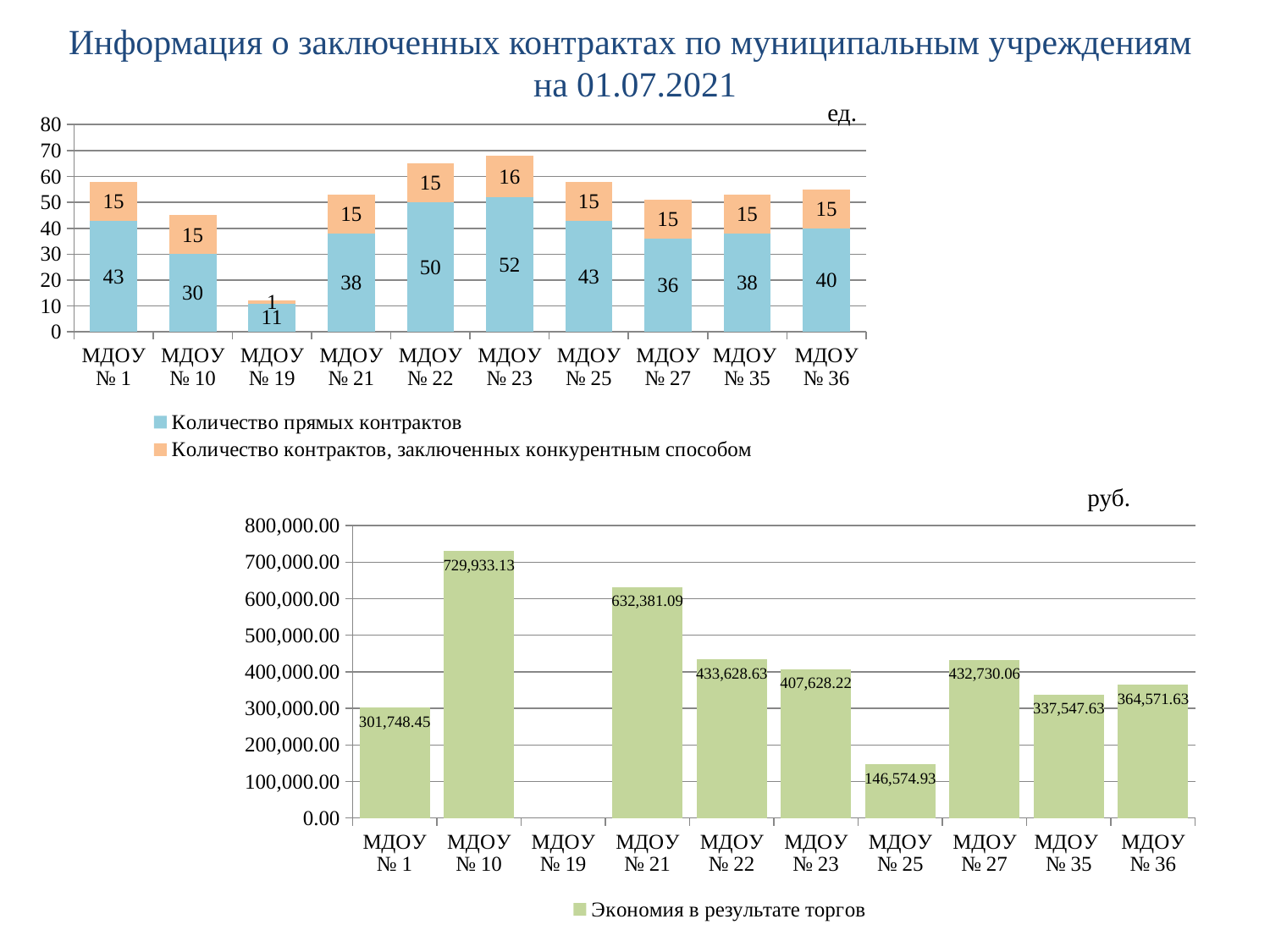
In the bottom chart (руб.), which is larger: the value for МДОУ № 21 or for МДОУ № 22? МДОУ № 21 In the top chart (ед.), what is the total height of the stacked bar for МДОУ № 22? 65 In the top chart (ед.), which institution has the highest number of direct contracts? МДОУ № 23 In the top chart (ед.), what is the difference in direct contracts between МДОУ № 22 and МДОУ № 10? 20 In the top chart (ед.), which institution has the lowest number of direct contracts? МДОУ № 19 What kind of chart is the bottom chart (руб.)? bar chart In the top chart (ед.), how many contracts concluded by competitive method does МДОУ № 19 have? 1 In the top chart (ед.), how many direct contracts (Количество прямых контрактов) does МДОУ № 23 have? 52 How many series does the legend of the top chart (ед.) list? 2 How many institutions are shown on the x axis of the top chart (ед.)? 10 In the bottom chart (руб.), which institution has the highest savings? МДОУ № 10 In the bottom chart (руб.), what is the value of Экономия в результате торгов for МДОУ № 27? 432,730.06